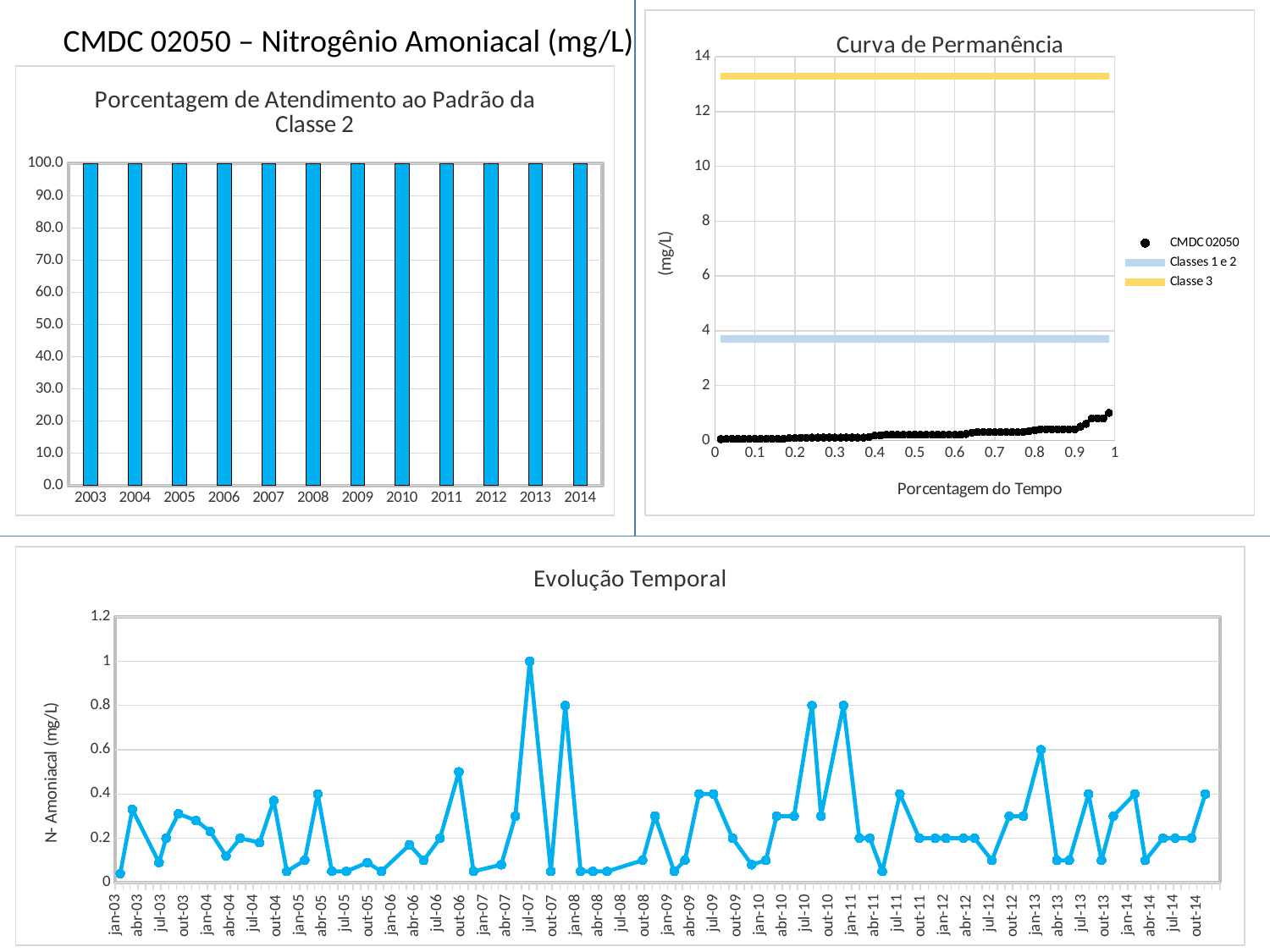
In the 'Porcentagem de Atendimento ao Padrão da Classe 2' chart, what is the value for 2008? 100.0 In the 'Evolução Temporal' chart, which date has the highest value? jul-07 In the 'Porcentagem de Atendimento ao Padrão da Classe 2' chart, how many years are plotted on the x axis? 12 In the 'Curva de Permanência' chart, is the 'Classes 1 e 2' line greater or less than 4 mg/L? less In the 'Curva de Permanência' chart, what is the label of the x axis? Porcentagem do Tempo In the 'Curva de Permanência' chart, is the 'Classe 3' line greater or less than 12 mg/L? greater In the 'Curva de Permanência' chart, how many series does the legend list? 3 In the 'Porcentagem de Atendimento ao Padrão da Classe 2' chart, what is the difference between the values for 2003 and 2013? 0.0 In the 'Porcentagem de Atendimento ao Padrão da Classe 2' chart, what kind of chart is shown? bar chart In the 'Porcentagem de Atendimento ao Padrão da Classe 2' chart, what is the value for 2014? 100.0 In the 'Evolução Temporal' chart, what is the value at jul-07? 1